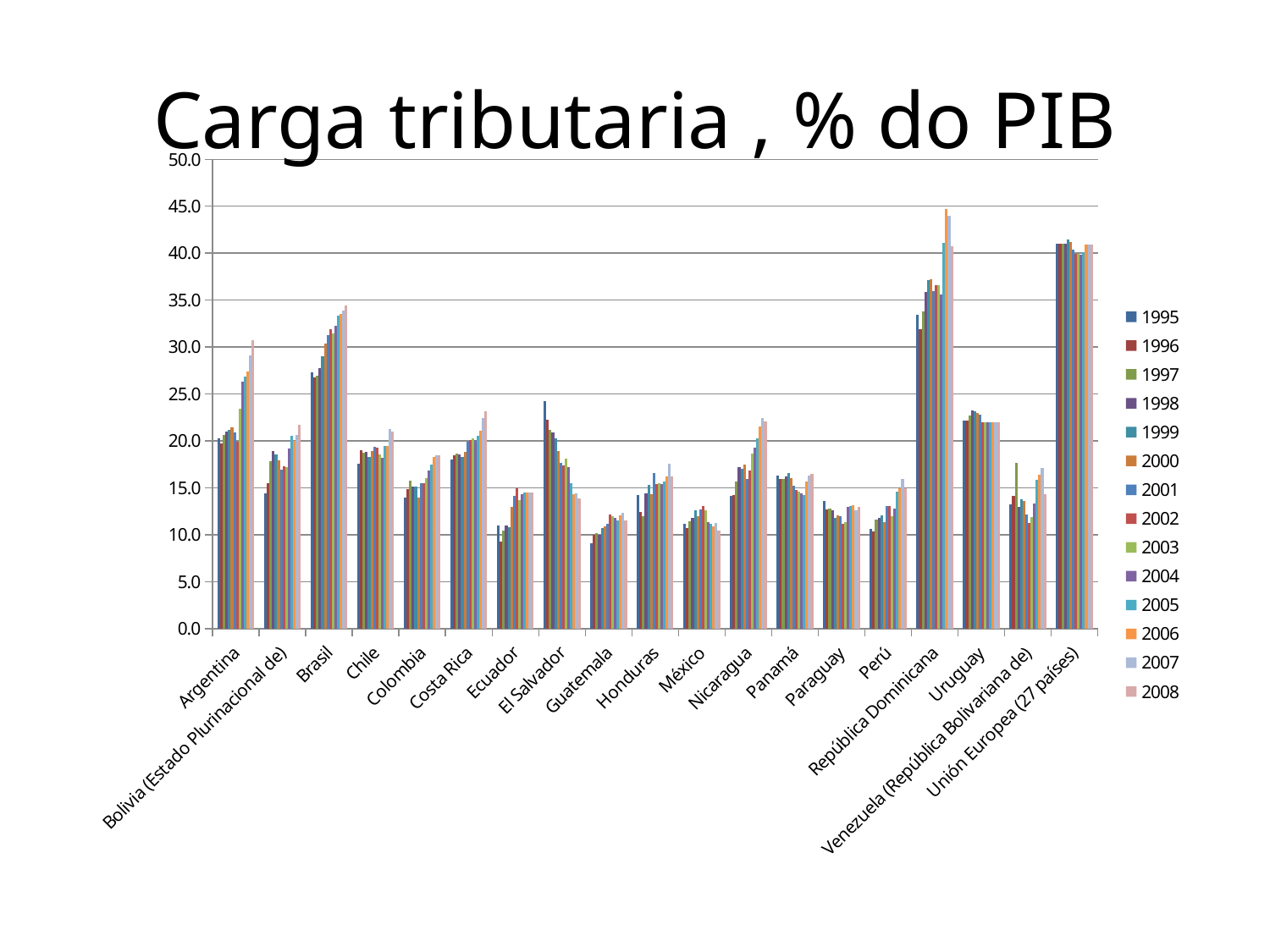
How many countries or regions are shown on the x axis? 19 Is the value for Brasil in 2008 greater or less than 30? greater Is the value for Guatemala in 1995 greater or less than 10? less Is the value for Paraguay in 2008 greater or less than 15? less Which category has the tallest bar in the chart? República Dominicana Do the values for El Salvador rise or fall from 1995 to 2008? fall Which is larger, the 2008 value for Brasil or the 2008 value for Chile? Brasil Do the values for Brasil rise or fall from 1995 to 2008? rise How many series does the legend list? 14 What is the title of the chart? Carga tributaria , % do PIB What type of chart is shown on the slide? bar chart